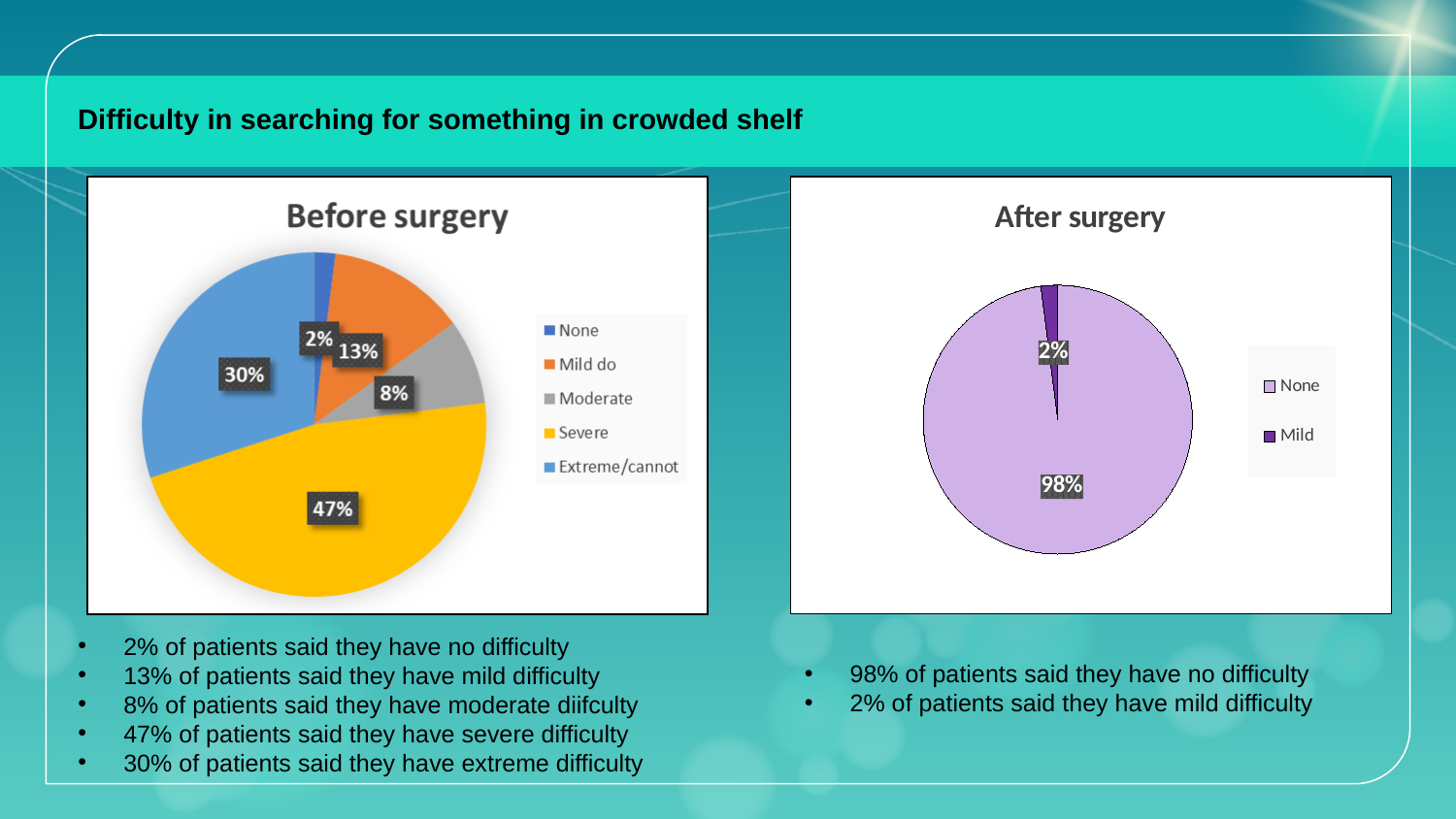
In the 'Before surgery' chart, which category has the largest slice? Severe In the 'Before surgery' chart, what is the difference between the Severe and Extreme/cannot percentages? 17% In the 'After surgery' chart, what percentage of patients reported no difficulty? 98% In the 'After surgery' chart, which category has the smaller slice? Mild What type of chart is the 'After surgery' chart? Pie chart In the 'Before surgery' chart, which is larger, the Mild slice or the Moderate slice? Mild How many entries does the legend of the 'After surgery' chart list? 2 In the 'Before surgery' chart, what colour is the Severe slice? Yellow How many categories does the 'Before surgery' pie chart show? 5 In the 'Before surgery' chart, what percentage of patients reported severe difficulty? 47% In the 'Before surgery' chart, what percentage of patients reported moderate difficulty? 8% In the 'Before surgery' chart, which category has the smallest slice? None